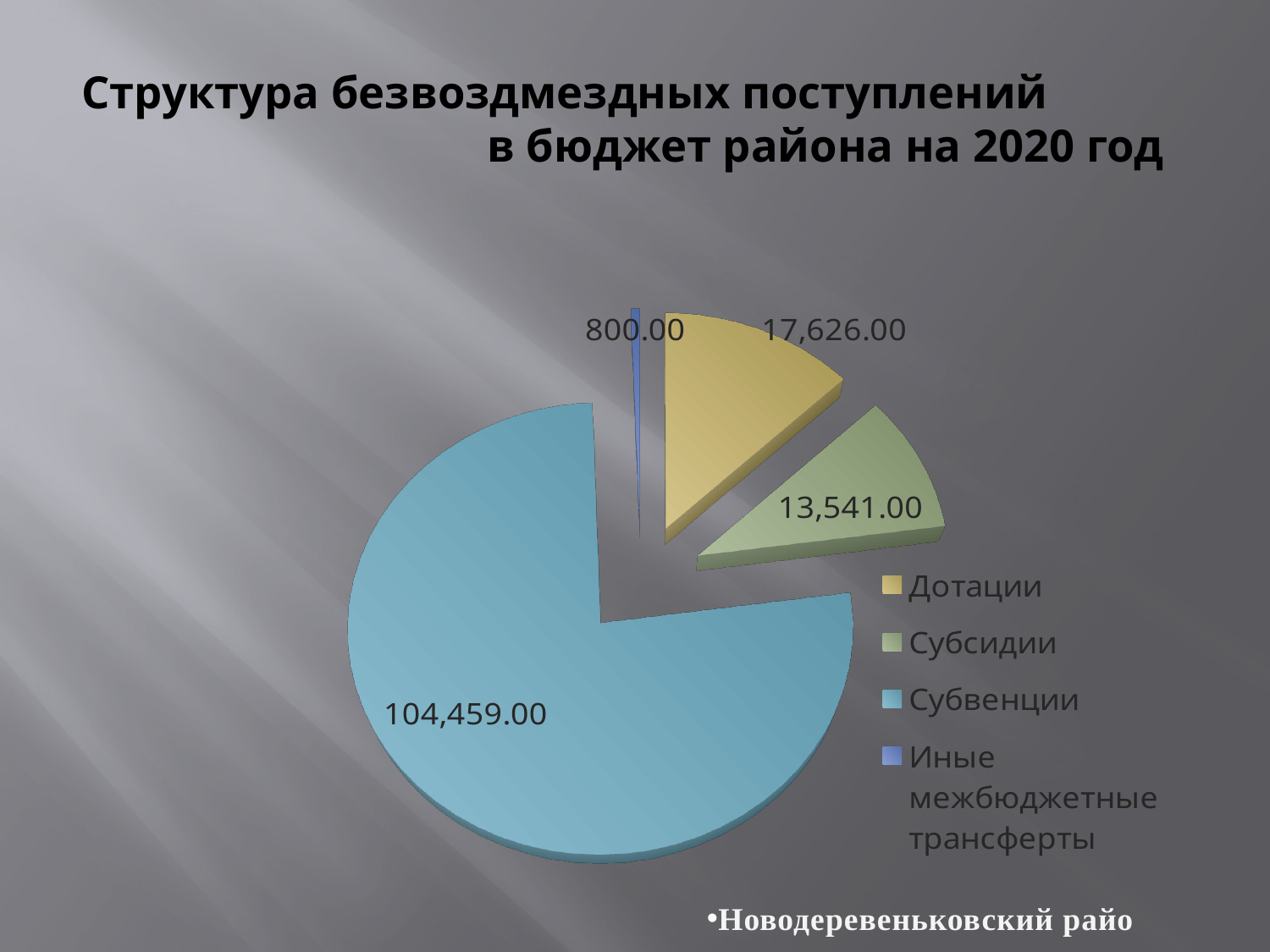
What is the value for Субвенции? 104,459.00 What is the value for Дотации? 17,626.00 How many categories does the pie chart have? 4 What is the title of the chart on the slide? Структура безвоздмездных поступлений в бюджет района на 2020 год What is the value for Субсидии? 13,541.00 What is the difference between the values for Дотации and Субсидии? 4,085.00 What is the value for Иные межбюджетные трансферты? 800.00 What is the difference between the values for Субвенции and Дотации? 86,833.00 Which category has the smallest slice of the pie? Иные межбюджетные трансферты What type of chart is shown on the slide? Pie chart Which category has the largest slice of the pie? Субвенции Which is larger, Дотации or Субсидии? Дотации